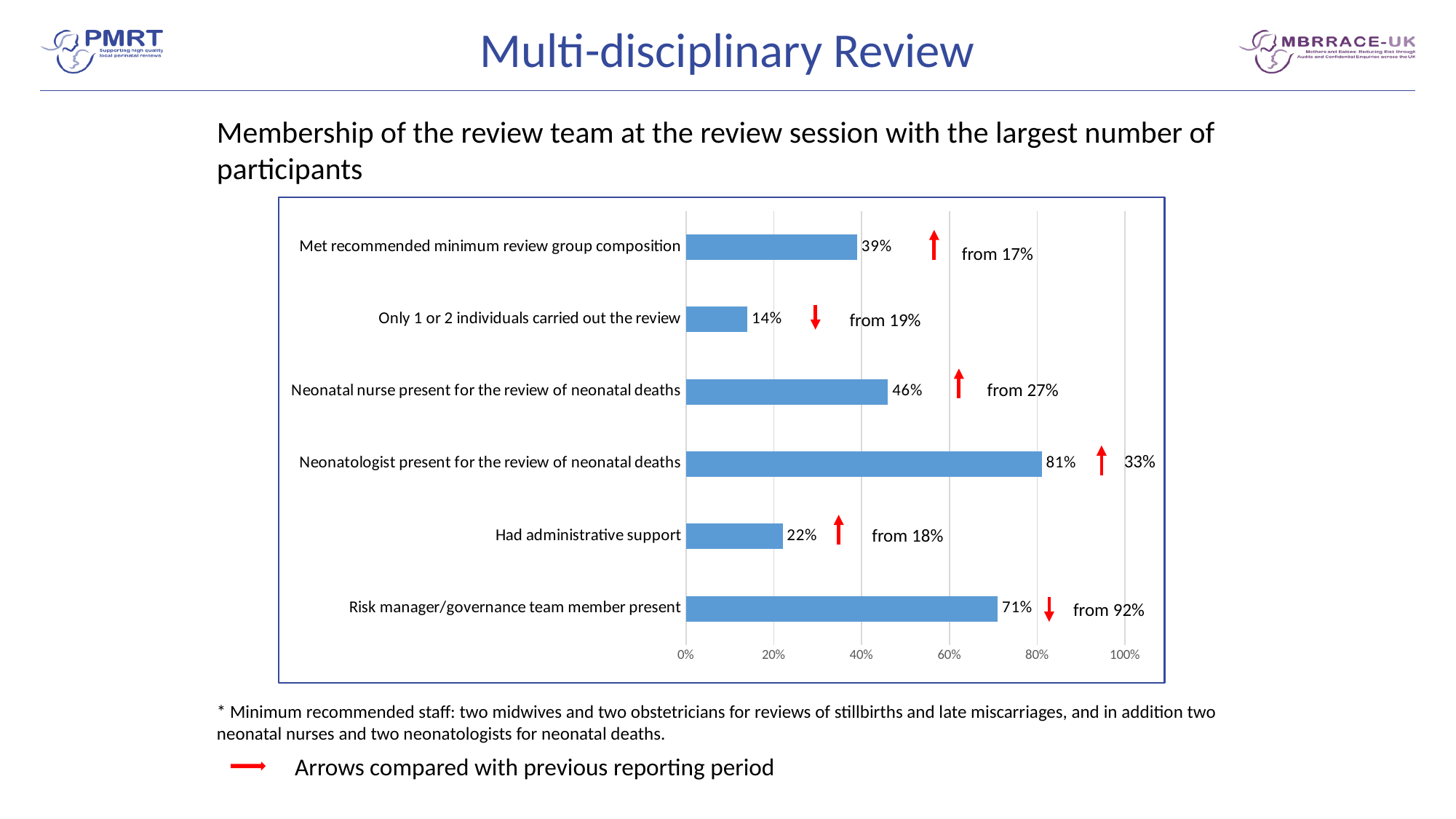
How many categories are shown in the chart? 6 Which category has the highest value? Neonatologist present for the review of neonatal deaths What is the value for 'Risk manager/governance team member present'? 71% Which category has the lowest value? Only 1 or 2 individuals carried out the review What is the value for 'Only 1 or 2 individuals carried out the review'? 14% What kind of chart is shown on the slide? Bar chart According to the annotation, what was the previous value for 'Risk manager/governance team member present'? 92% Is the value for 'Risk manager/governance team member present' greater or less than 60%? greater What is the value for 'Neonatologist present for the review of neonatal deaths'? 81% What is the value for 'Met recommended minimum review group composition'? 39% Which is larger: the value for 'Had administrative support' or the value for 'Met recommended minimum review group composition'? Met recommended minimum review group composition What is the difference between the values for 'Neonatologist present for the review of neonatal deaths' and 'Neonatal nurse present for the review of neonatal deaths'? 35%